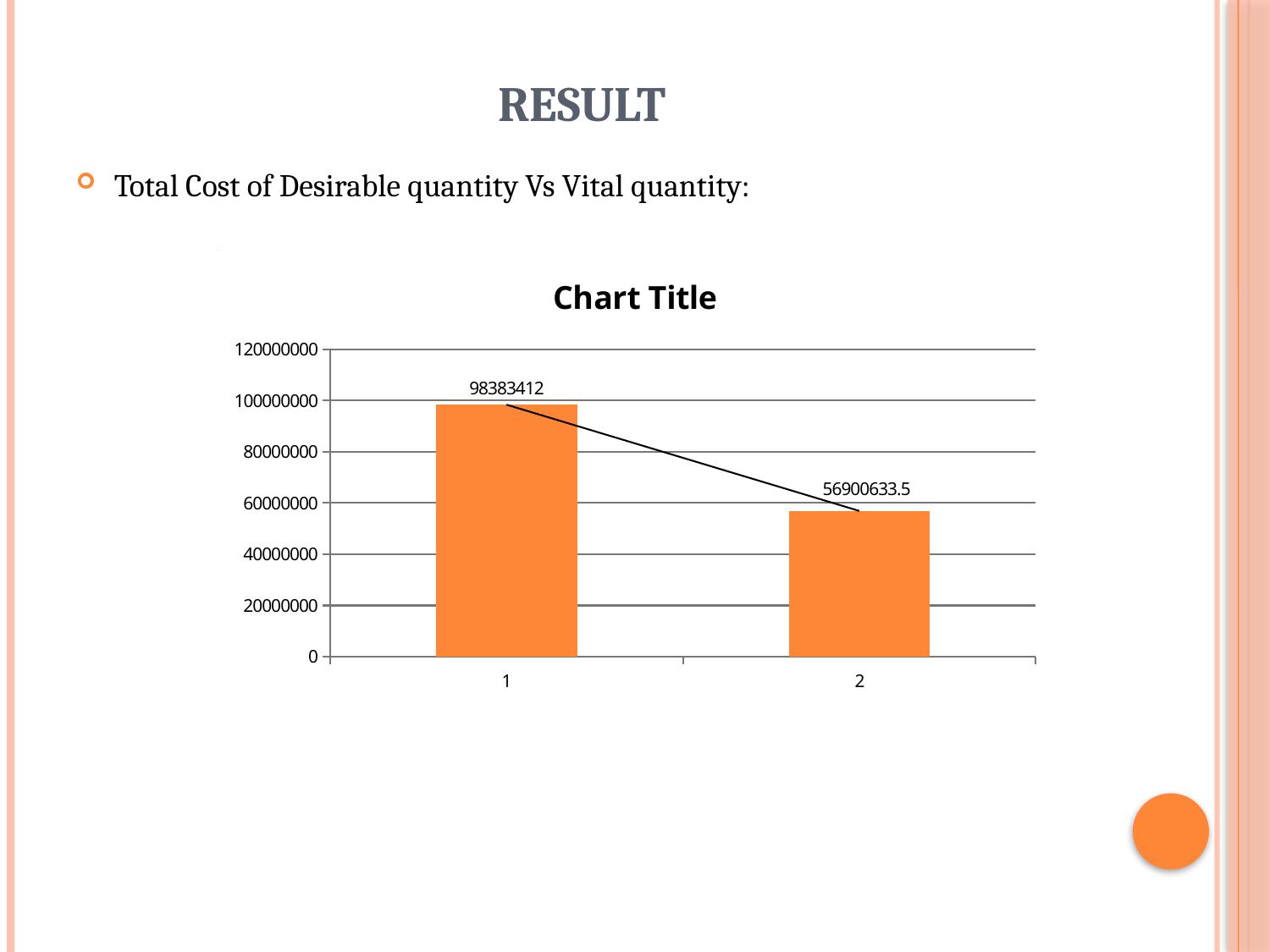
What is the value for category 1? 98383412 Which category has the highest value? 1 What is the value for category 2? 56900633.5 Which is larger, the value for category 1 or the value for category 2? 1 What is the title of the chart? Chart Title What kind of chart is shown on the slide? bar chart What is the difference between the values for category 1 and category 2? 41482778.5 Is the value for category 2 greater or less than 60000000? less Is the value for category 1 greater or less than 80000000? greater Which category has the lowest value? 2 Do the values rise or fall from category 1 to category 2? fall How many categories are shown on the x axis? 2